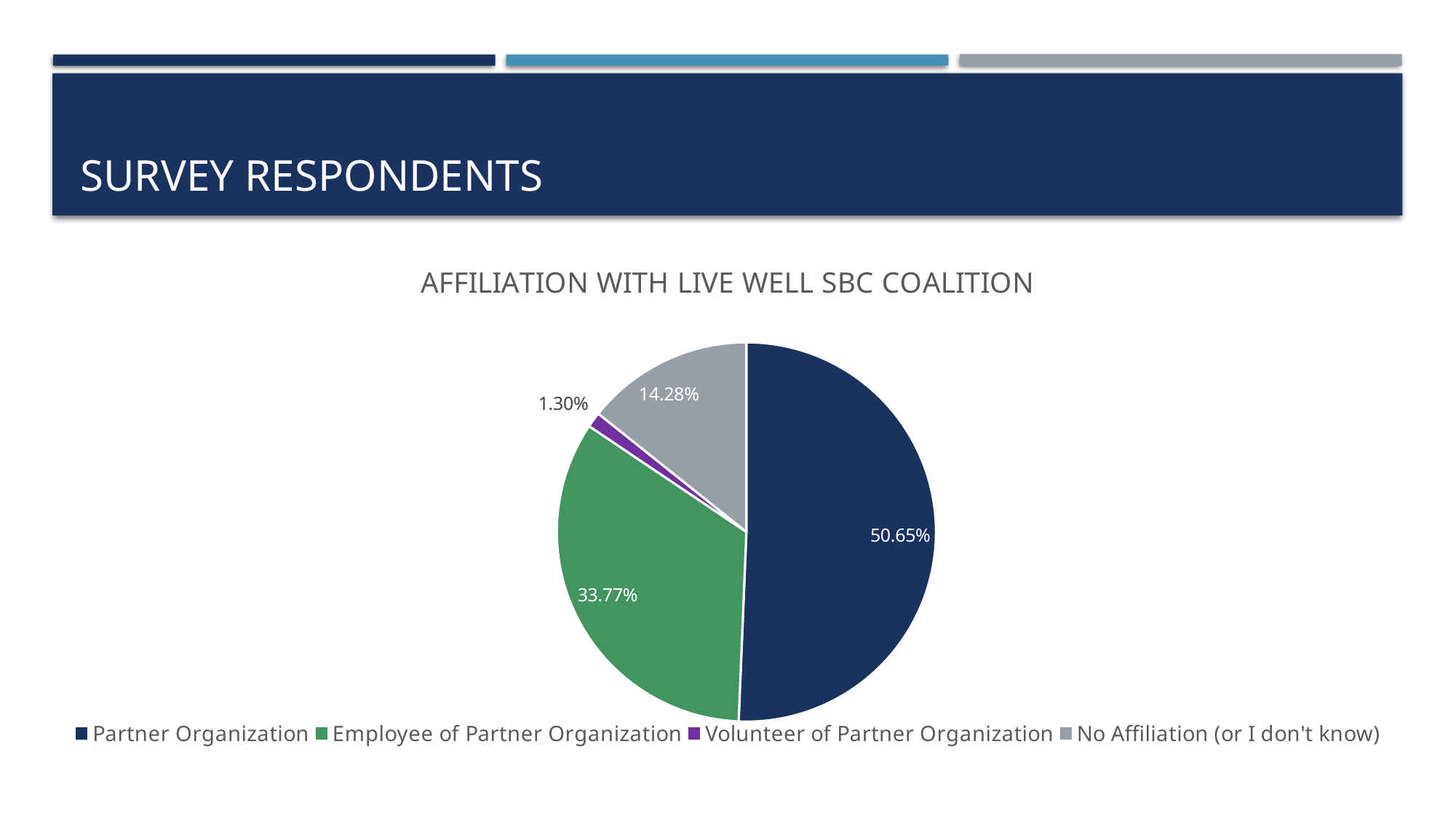
What colour is the slice for Volunteer of Partner Organization? Purple Which is larger: the share for Employee of Partner Organization or the share for No Affiliation (or I don't know)? Employee of Partner Organization Which category has the largest slice of the pie? Partner Organization What is the title of the chart? Affiliation with Live Well SBC Coalition What share of respondents are from a Partner Organization? 50.65% How many categories does the pie chart show? 4 What is the difference in percentage points between the Partner Organization share and the Employee of Partner Organization share? 16.88 What type of chart is shown on the slide? Pie chart Which category has the smallest slice of the pie? Volunteer of Partner Organization What share of respondents have No Affiliation (or I don't know)? 14.28% What share of respondents are a Volunteer of Partner Organization? 1.30% What share of respondents are an Employee of Partner Organization? 33.77%